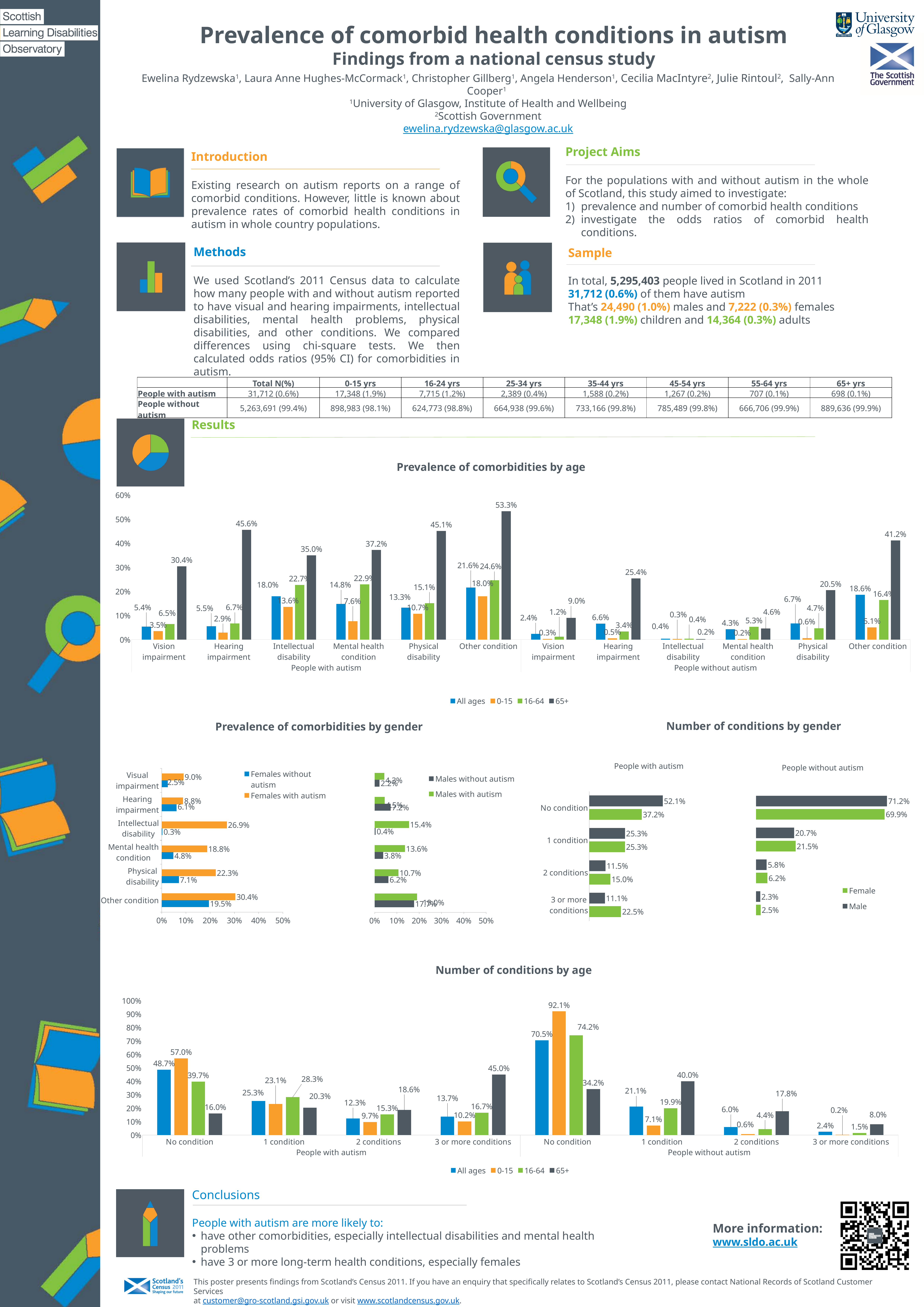
In the 'Number of conditions by gender' chart, what is the Female value for 3 or more conditions among people with autism? 22.5% In the 'Prevalence of comorbidities by gender' chart, what is the value for Intellectual disability among females with autism? 26.9% In the 'Number of conditions by age' chart, which is larger for No condition among people with autism: the 0-15 value or the 65+ value? 0-15 In the 'Number of conditions by age' chart, what is the 0-15 value for No condition among people without autism? 92.1% In the 'Number of conditions by age' chart, what is the 65+ value for 3 or more conditions among people with autism? 45.0% In the 'Prevalence of comorbidities by age' chart, what is the All ages value for Intellectual disability among people with autism? 18.0% What kind of chart is 'Number of conditions by age'? Bar chart How many series does the legend of the 'Prevalence of comorbidities by age' chart list? 4 In the 'Prevalence of comorbidities by gender' chart, what is the difference between females with autism and females without autism for Other condition? 10.9% In the 'Prevalence of comorbidities by age' chart, what is the value for Other condition among people with autism aged 65+? 53.3% In the 'Number of conditions by gender' chart, what is the difference between the Male and Female values for No condition among people with autism? 14.9% In the 'Prevalence of comorbidities by age' chart, which age group has the highest value for Hearing impairment among people with autism? 65+